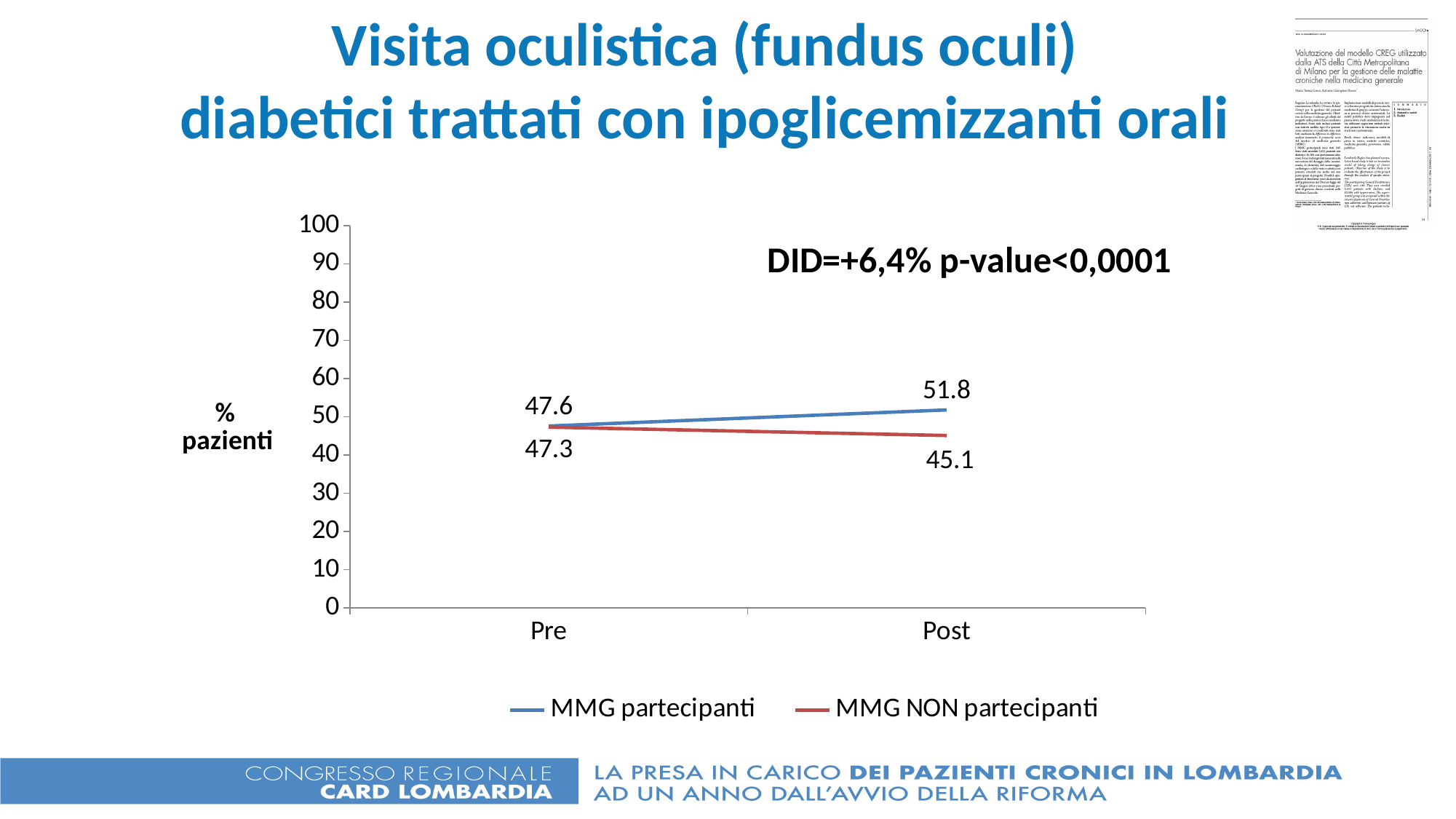
Does the value for MMG NON partecipanti rise or fall from Pre to Post? fall What is the value for MMG partecipanti at Post? 51.8 Which series has the higher value at Post? MMG partecipanti How many series does the legend list? 2 How many categories are shown on the x axis? 2 What is the value for MMG NON partecipanti at Post? 45.1 Does the value for MMG partecipanti rise or fall from Pre to Post? rise What is the value for MMG NON partecipanti at Pre? 47.3 By how much did the value for MMG partecipanti change from Pre to Post? 4.2 What is the value for MMG partecipanti at Pre? 47.6 What is the difference between MMG partecipanti and MMG NON partecipanti at Post? 6.7 What kind of chart is shown on the slide? line chart